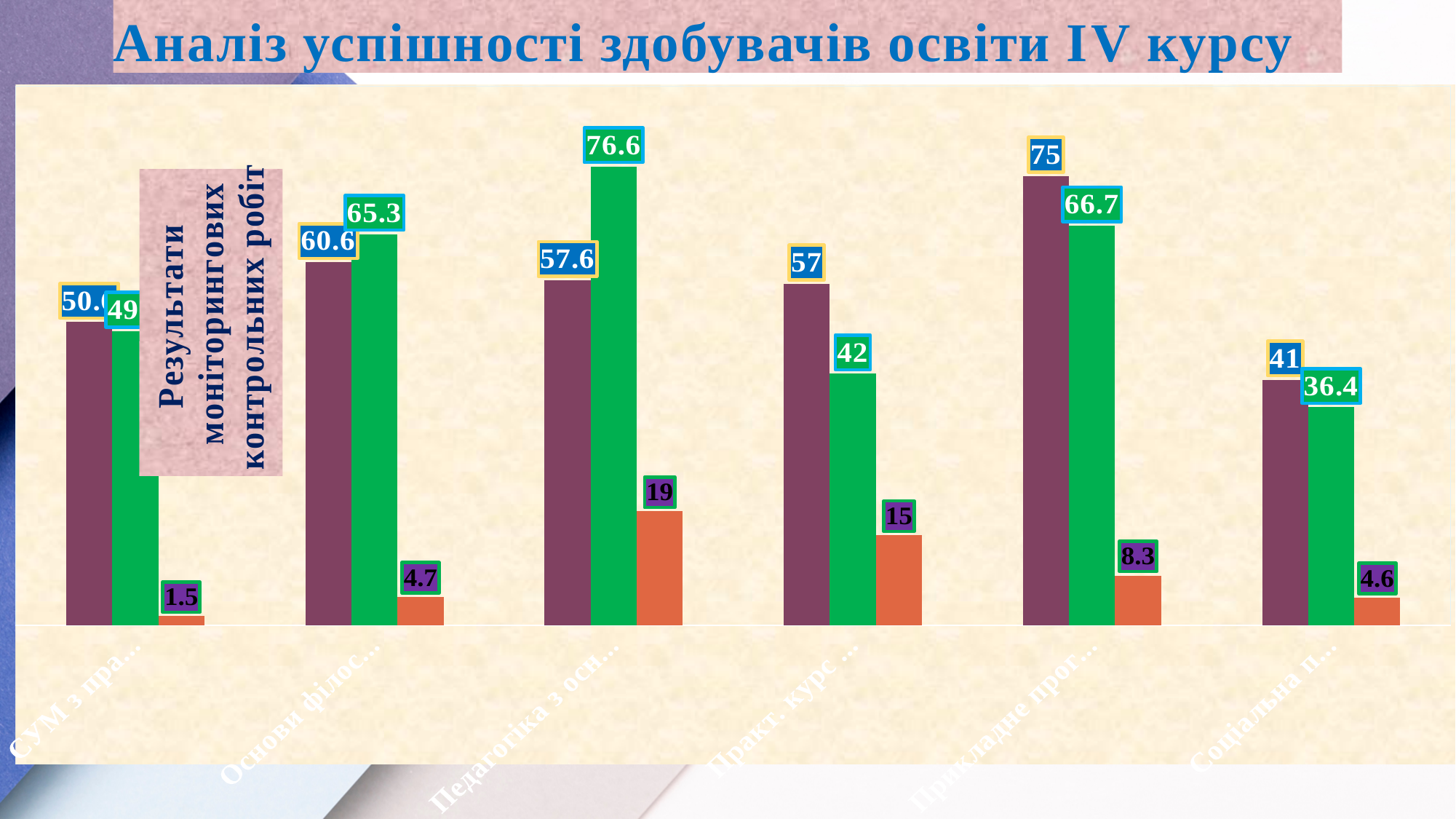
For the category 'Педагогіка з осн...', what is the difference between the green bar (76.6) and the purple bar (57.6)? 19 How many categories (subjects) are shown along the x axis of the chart? 6 What is the value of the green bar for the category 'Педагогіка з осн...'? 76.6 What is the value of the orange bar for the category 'Основи філос...'? 4.7 What is the value of the green bar for the category 'Соціальна п...'? 36.4 What is the value of the purple bar for the category 'Прикладне прог...'? 75 What text is written in the box placed over the chart area? Результати моніторингових контрольних робіт How many bars (series) are plotted for each category in the chart? 3 Which category has the highest green bar? Педагогіка з осн... What kind of chart is shown on the slide? bar chart For the category 'Прикладне прог...', which is larger: the purple bar or the green bar? the purple bar (75) Which category has the lowest orange bar? СУМ з пра...